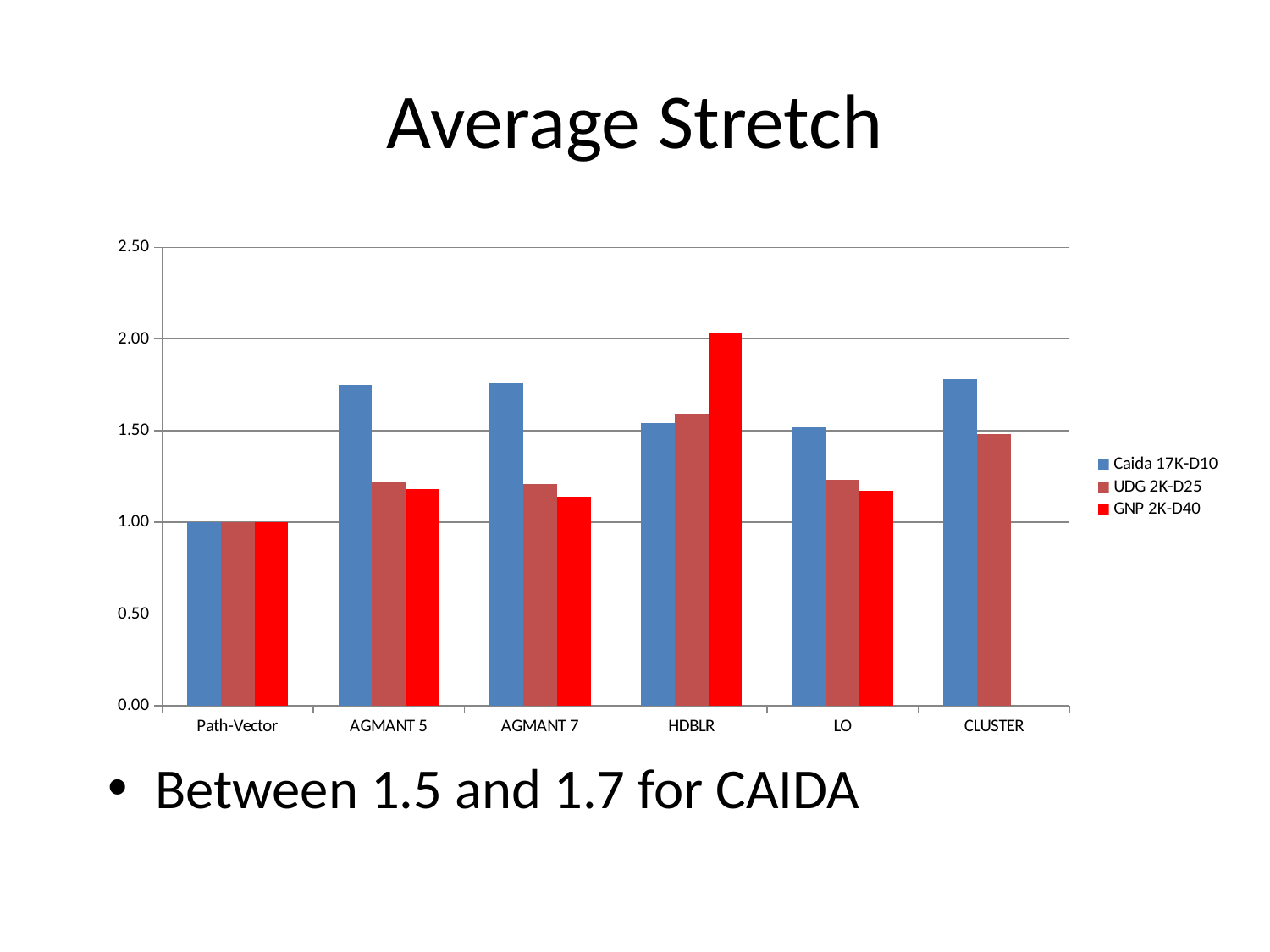
Which category has the highest value for GNP 2K-D40? HDBLR Is the value for Caida 17K-D10 at CLUSTER greater or less than 2.00? less Is the value for Caida 17K-D10 at AGMANT 5 greater or less than 1.50? greater Which category has the highest value for UDG 2K-D25? HDBLR What is the value for GNP 2K-D40 at Path-Vector? 1.00 Which category has the lowest value for Caida 17K-D10? Path-Vector What is the title of the chart? Average Stretch What is the value for Caida 17K-D10 at Path-Vector? 1.00 How many series does the legend list? 3 At HDBLR, which series has the larger value: Caida 17K-D10 or GNP 2K-D40? GNP 2K-D40 How many categories are shown on the x axis? 6 What kind of chart is shown on the slide? bar chart